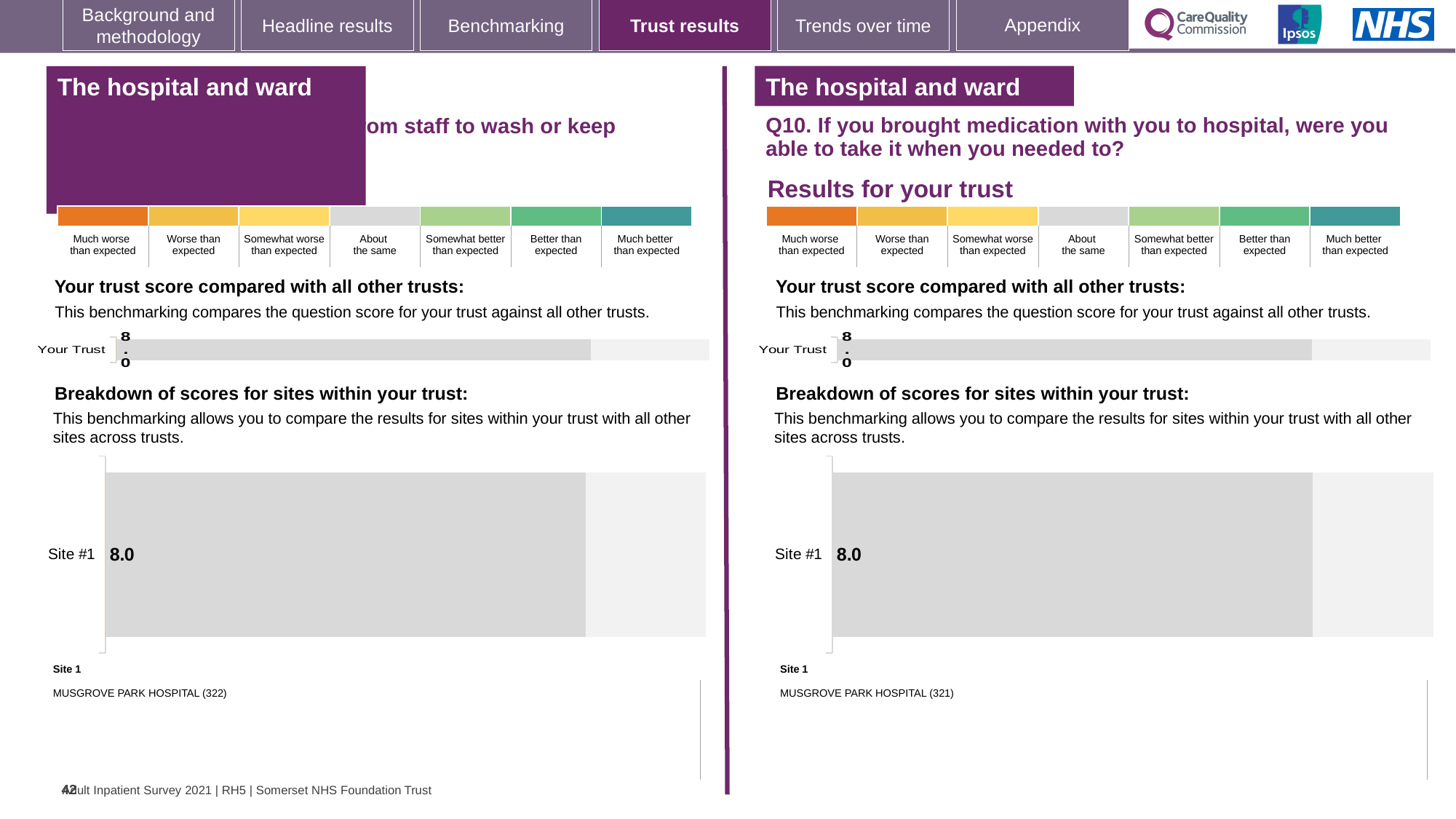
On the left-hand panel, which hospital is listed as Site 1 below the breakdown chart? MUSGROVE PARK HOSPITAL (322) On the right-hand panel (Q10), what is the score shown for Your Trust in the 'Your trust score compared with all other trusts' chart? 8.0 On the right-hand panel (Q10), is the Your Trust score larger than, smaller than, or equal to the Site #1 score? Equal On the right-hand panel (Q10), which hospital is listed as Site 1 below the breakdown chart? MUSGROVE PARK HOSPITAL (321) On the left-hand panel, what score is shown for Site #1 in the 'Breakdown of scores for sites within your trust' chart? 8.0 On the left-hand panel, what is the score shown for Your Trust in the 'Your trust score compared with all other trusts' chart? 8.0 On the right-hand panel (Q10), what score is shown for Site #1 in the 'Breakdown of scores for sites within your trust' chart? 8.0 What kind of chart is used to show the Site #1 score on the right-hand panel? Bar chart On the left-hand panel, how many sites are plotted in the 'Breakdown of scores for sites within your trust' chart? 1 On the right-hand panel (Q10), how many sites are plotted in the 'Breakdown of scores for sites within your trust' chart? 1